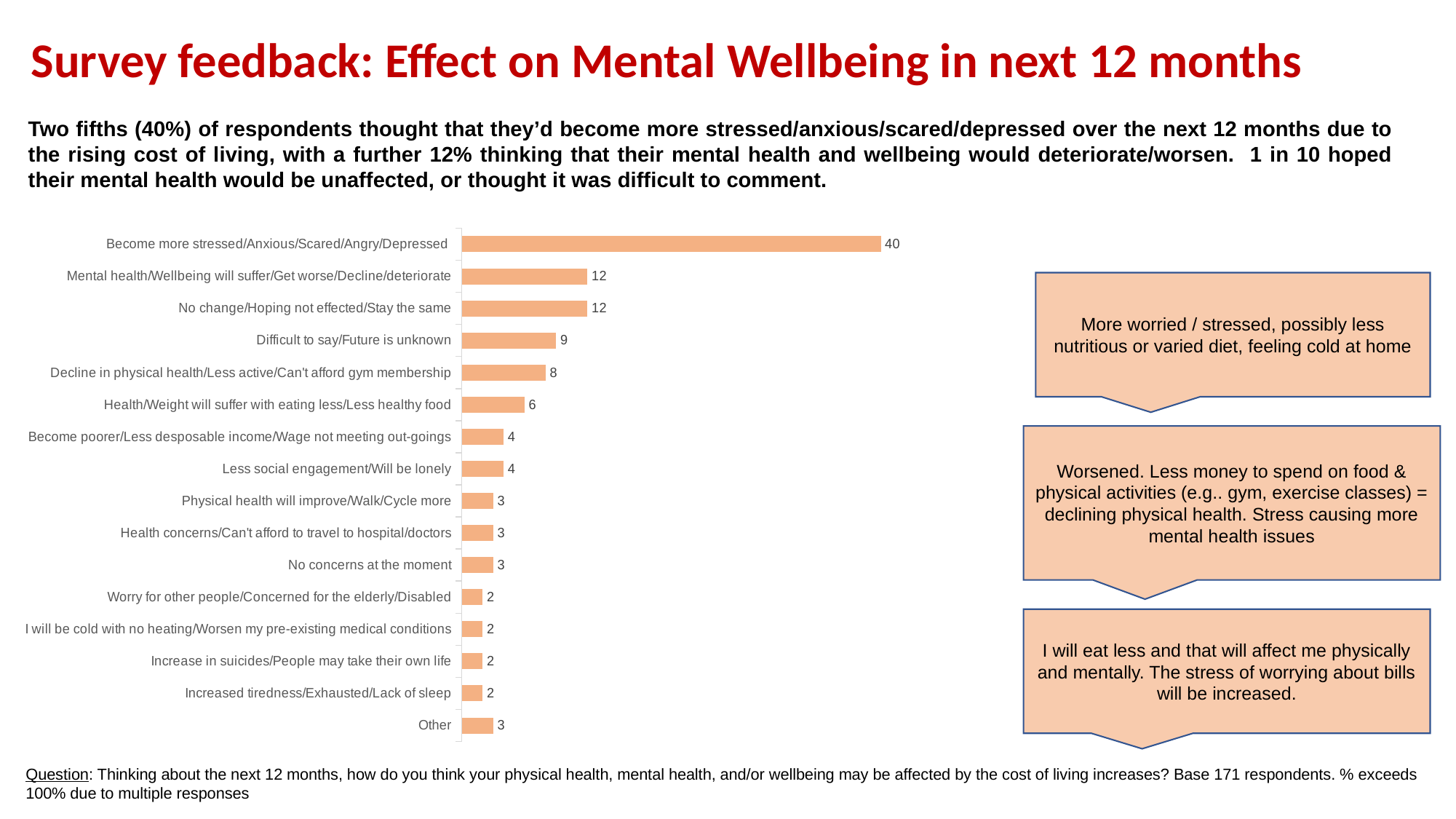
What is the value for "Become more stressed/Anxious/Scared/Angry/Depressed"? 40 What kind of chart is shown on the slide? Bar chart How many categories are shown in the chart? 16 What colour are the bars in the chart? Orange Which is larger, the value for "Decline in physical health/Less active/Can't afford gym membership" or the value for "Health/Weight will suffer with eating less/Less healthy food"? Decline in physical health/Less active/Can't afford gym membership Which category has the highest value? Become more stressed/Anxious/Scared/Angry/Depressed What is the value for "Difficult to say/Future is unknown"? 9 What is the value for "Decline in physical health/Less active/Can't afford gym membership"? 8 What is the difference between the values for "Become more stressed/Anxious/Scared/Angry/Depressed" and "Mental health/Wellbeing will suffer/Get worse/Decline/deteriorate"? 28 What is the value for "Other"? 3 What is the difference between the values for "Difficult to say/Future is unknown" and "Less social engagement/Will be lonely"? 5 What is the value for "Health/Weight will suffer with eating less/Less healthy food"? 6